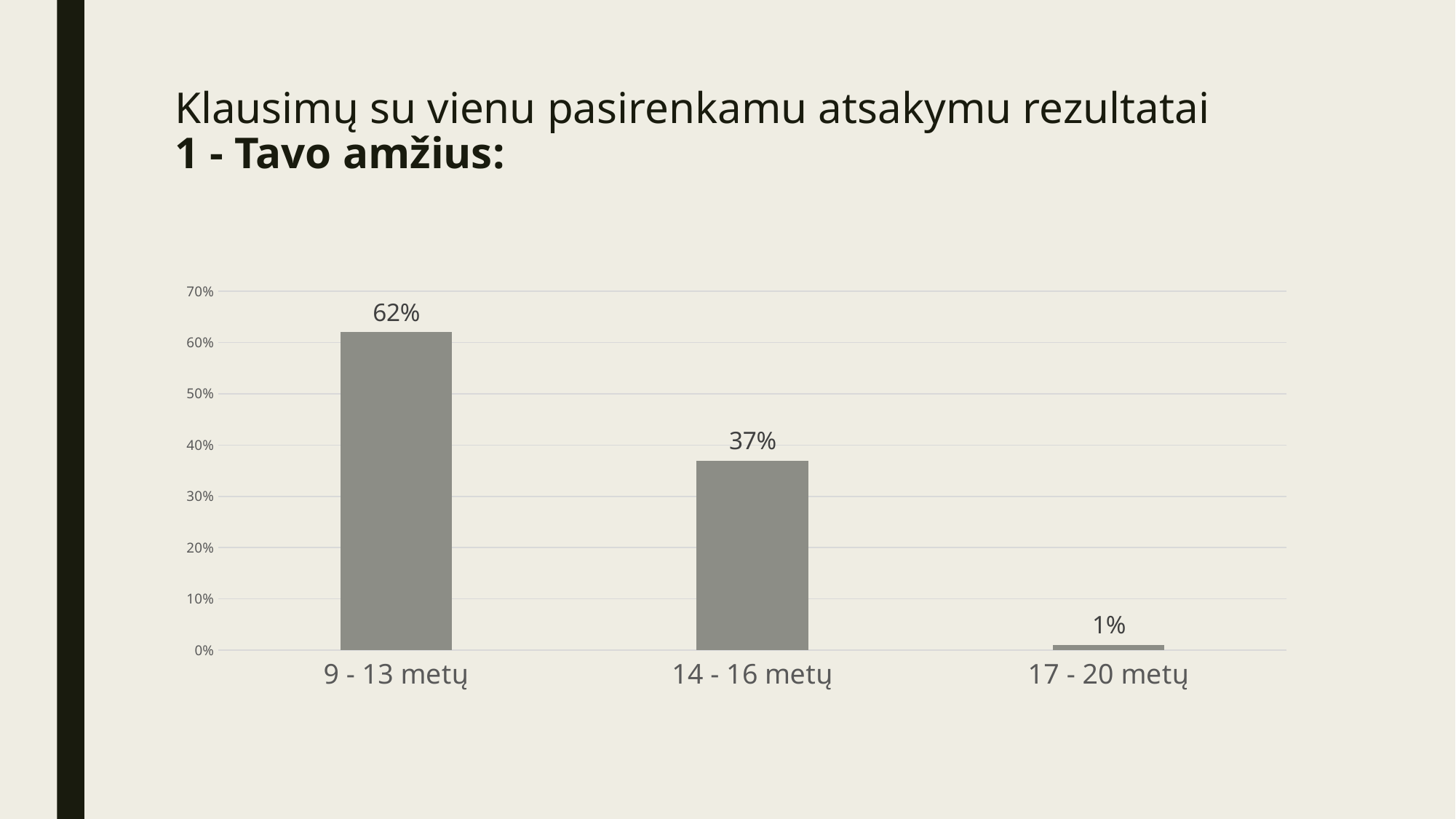
Is the value for 9 - 13 metų greater or less than 50%? greater Which age group has the highest value? 9 - 13 metų What is the value for 14 - 16 metų? 37% What kind of chart is shown on the slide? bar chart What is the value for 9 - 13 metų? 62% How many age groups are shown in the chart? 3 Which age group has the lowest value? 17 - 20 metų What is the value for 17 - 20 metų? 1% Do the values rise or fall from left to right across the age groups? fall What is the difference between the values for 9 - 13 metų and 14 - 16 metų? 25% What is the difference between the values for 14 - 16 metų and 17 - 20 metų? 36% Which is larger, the value for 14 - 16 metų or the value for 17 - 20 metų? 14 - 16 metų